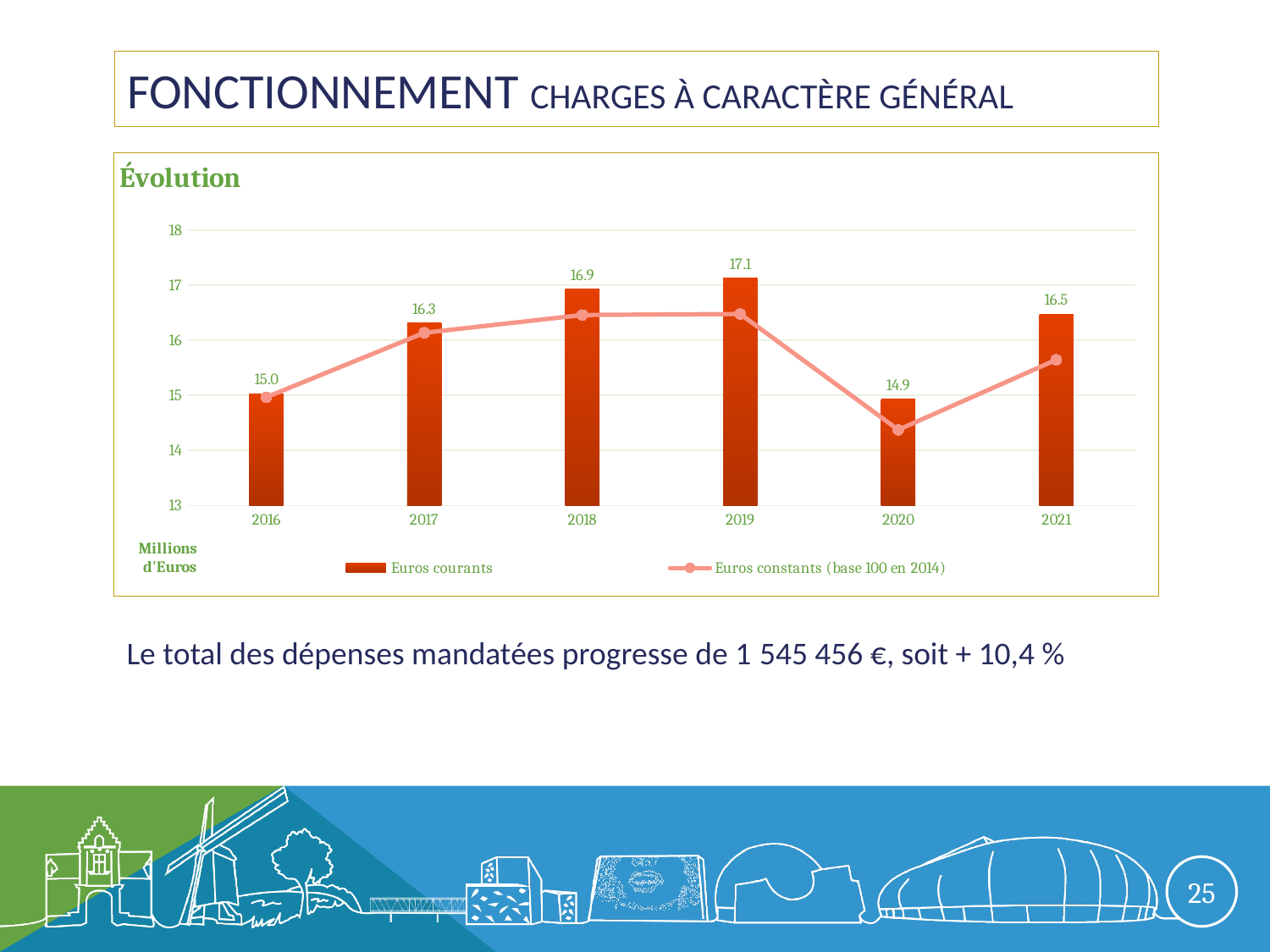
Which year has the highest value for Euros courants? 2019 Is the Euros constants value for 2020 greater or less than 15? less What is the value of Euros courants for 2016? 15.0 How many series does the legend list? 2 Is the Euros constants value for 2018 greater or less than 16? greater How many years are shown on the x axis? 6 Which is larger, the Euros courants value for 2017 or for 2021? 2021 What is the difference between the Euros courants values for 2019 and 2020? 2.2 Which year has the lowest value for Euros courants? 2020 What is the value of Euros courants for 2019? 17.1 What is the unit shown for the y axis? Millions d'Euros What is the value of Euros courants for 2021? 16.5